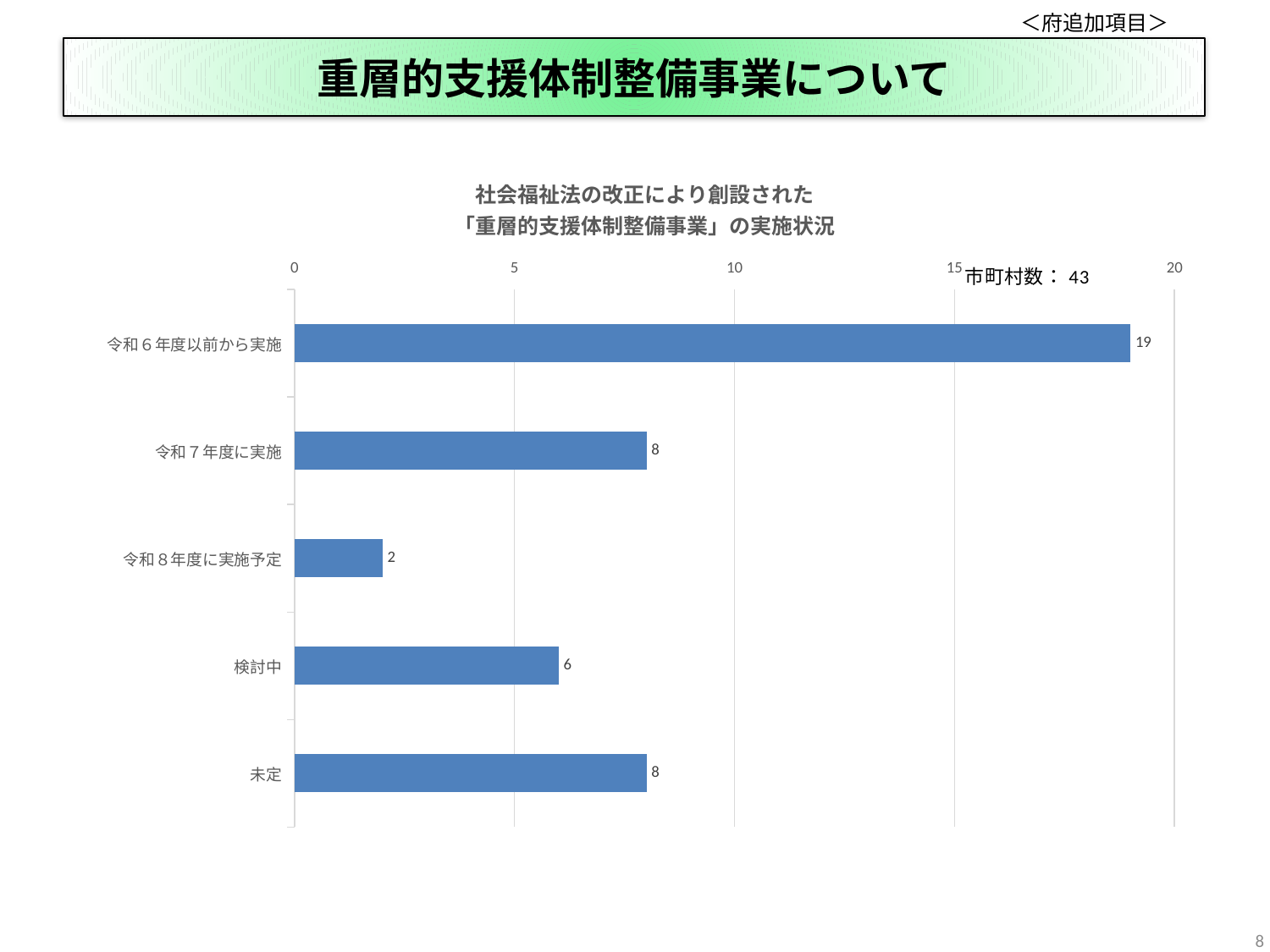
What is the difference between the values for 令和６年度以前から実施 and 令和７年度に実施? 11 What is the value for 令和６年度以前から実施? 19 How many categories are shown in the chart? 5 Which is larger, the value for 検討中 or the value for 未定? 未定 What is the value for 令和７年度に実施? 8 What is the total number of municipalities (市町村数) noted on the chart? 43 What kind of chart is shown on the slide? bar chart Which category has the lowest value? 令和８年度に実施予定 What is the value for 令和８年度に実施予定? 2 Is the value for 令和６年度以前から実施 greater or less than 15? greater Which category has the highest value? 令和６年度以前から実施 What is the value for 検討中? 6